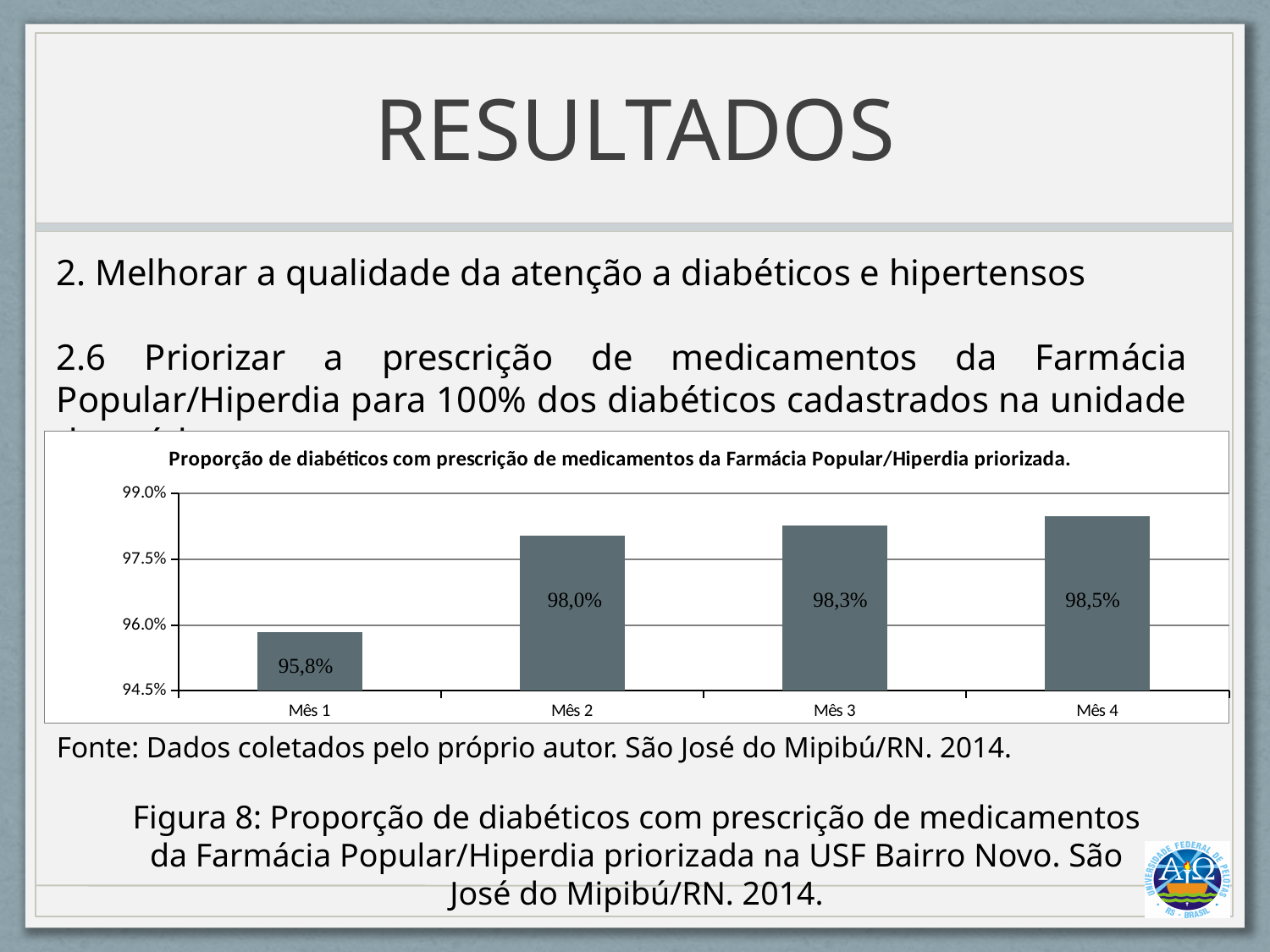
What is the difference between the values for Mês 2 and Mês 1? 2,2% Which month has the lowest value? Mês 1 Which month has the highest value? Mês 4 What kind of chart is shown? bar chart What is the value for Mês 4? 98,5% What is the difference between the values for Mês 4 and Mês 1? 2,7% How many months are shown on the x axis? 4 Do the values rise or fall from Mês 1 to Mês 4? rise Which is larger, the value for Mês 2 or the value for Mês 1? Mês 2 What is the value for Mês 3? 98,3% What is the value for Mês 1? 95,8% Is the value for Mês 1 greater or less than 96.0%? less